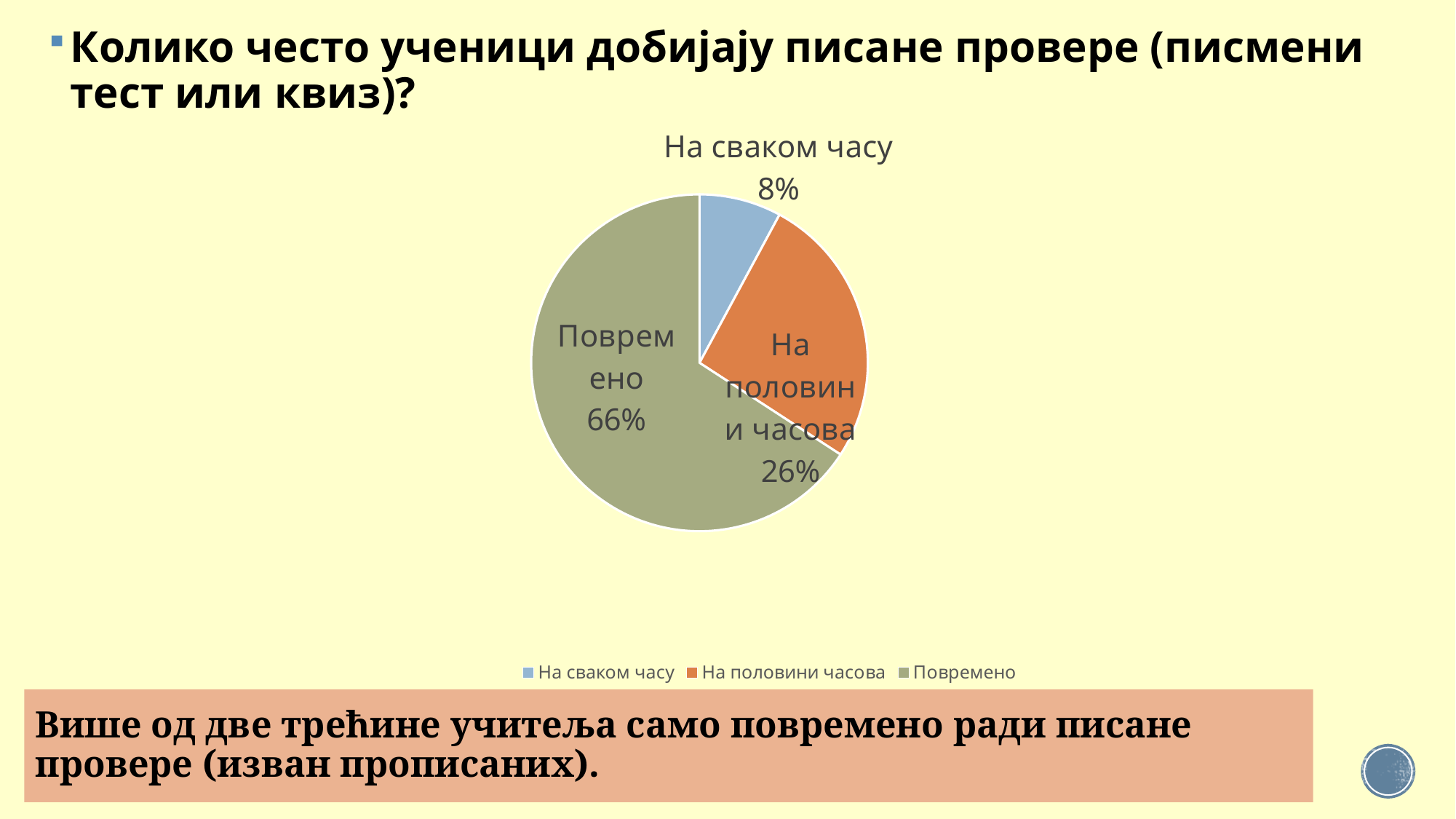
What kind of chart is shown on the slide? pie chart What percentage is shown for the slice labelled "На сваком часу"? 8% What colour is the slice for "На половини часова"? orange What percentage is shown for the slice labelled "На половини часова"? 26% How many entries does the legend list? 3 What is the difference in percentage points between "На половини часова" and "На сваком часу"? 18 Which is larger, the slice for "На половини часова" or the slice for "На сваком часу"? На половини часова What percentage is shown for the slice labelled "Повремено"? 66% What is the difference in percentage points between "Повремено" and "На половини часова"? 40 Which slice of the pie chart is the smallest? На сваком часу How many slices does the pie chart have? 3 Which slice of the pie chart is the largest? Повремено